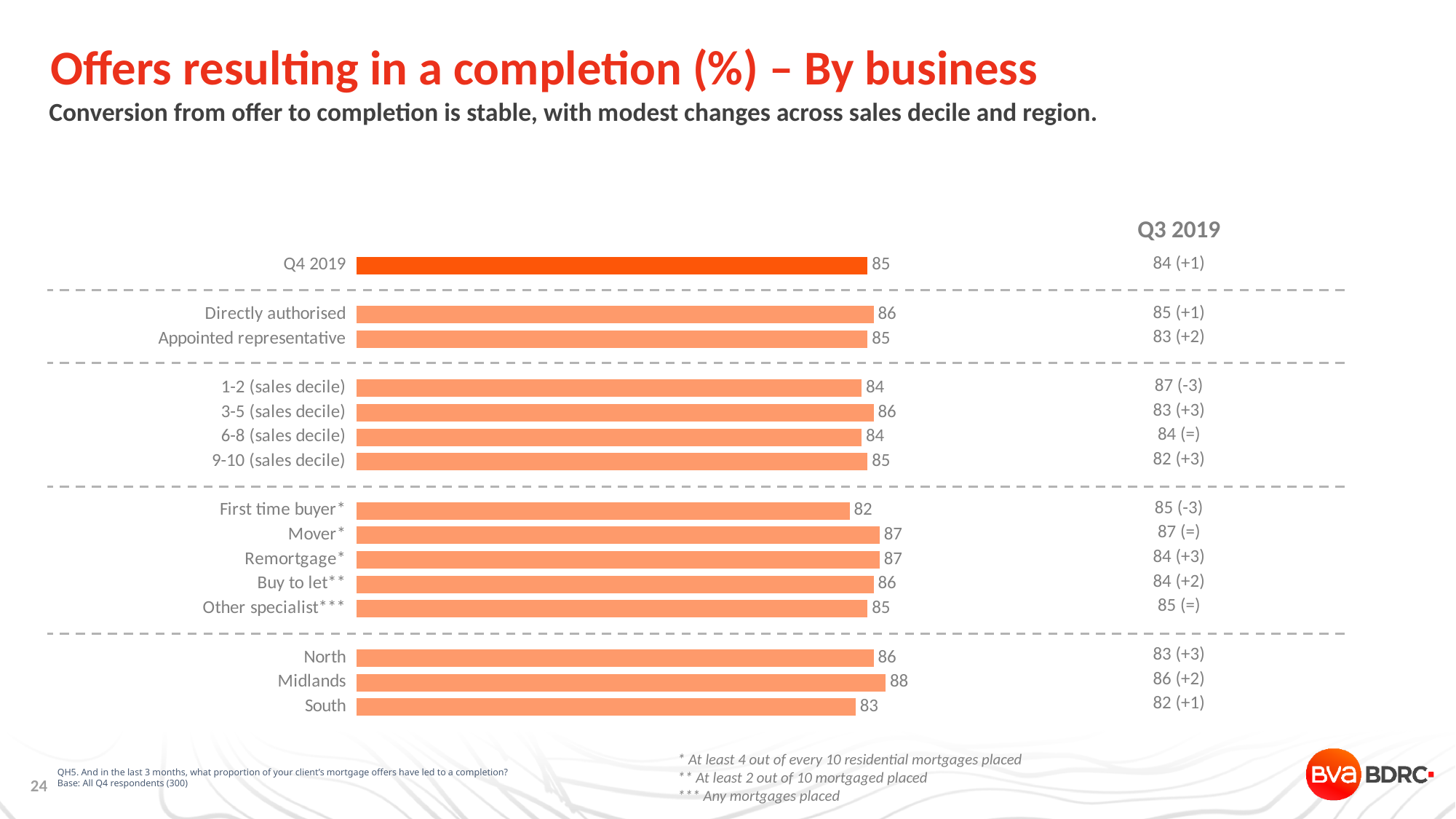
Which category has the lowest value? First time buyer What is the value for First time buyer? 82 How many bars are plotted in the chart? 15 Which category has the highest value? Midlands What kind of chart is shown on the slide? Bar chart What is the difference between the values for Midlands and South? 5 What is the difference between the values for Mover and First time buyer? 5 What is the Q3 2019 value shown for Midlands? 86 (+2) What is the value for Midlands? 88 What is the value for the 6-8 (sales decile) category? 84 What is the value for Directly authorised? 86 Which is larger, the value for North or the value for South? North